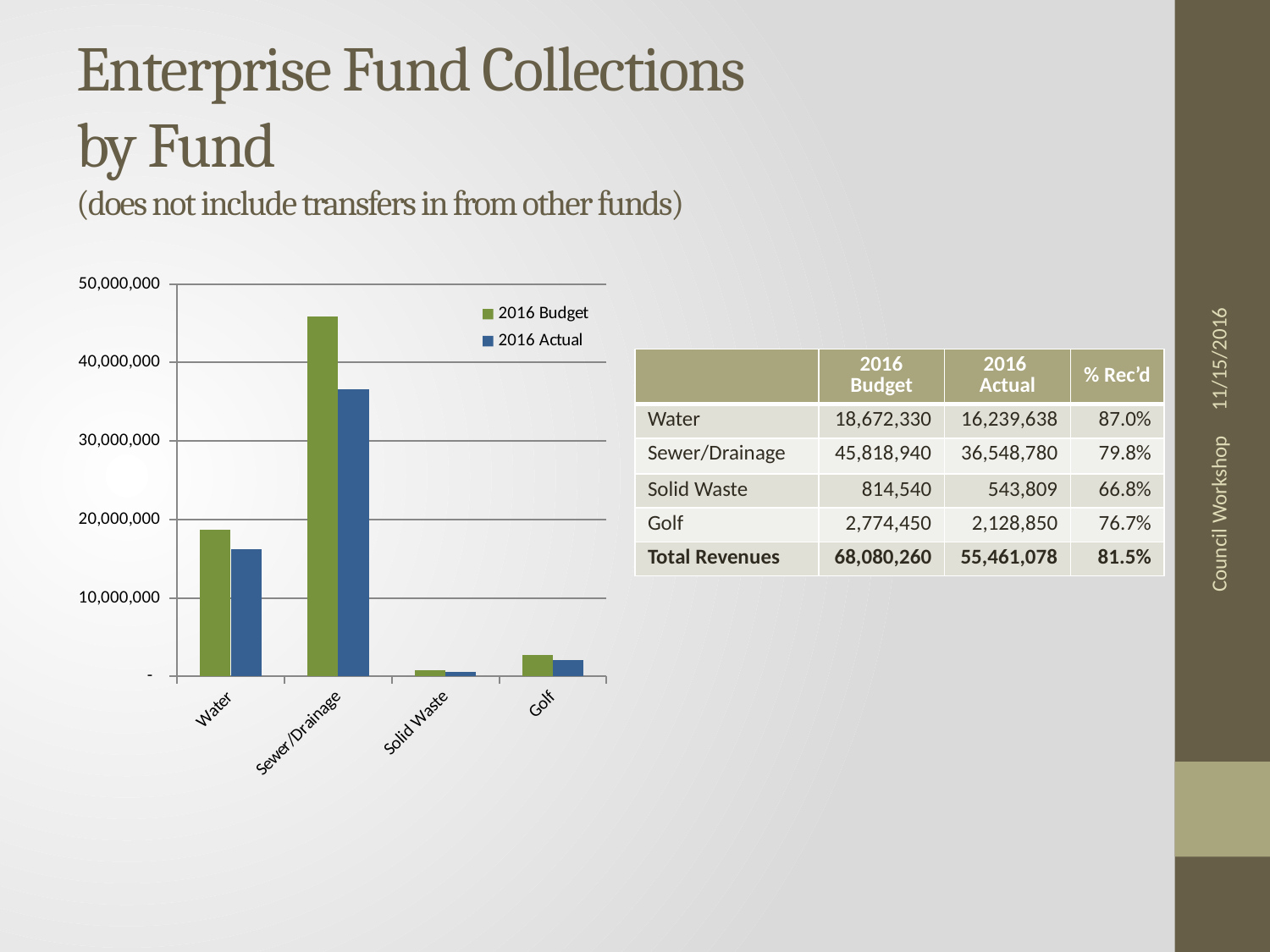
How many fund categories are shown on the x axis of the chart? 4 Is the 2016 Actual bar for Water greater or less than 20,000,000? less Which fund has the highest 2016 Budget bar in the chart? Sewer/Drainage Which fund has the lowest 2016 Actual bar in the chart? Solid Waste What kind of chart is shown on the slide? bar chart According to the table on the slide, what is the 2016 Actual value for Water? 16,239,638 According to the table on the slide, what is the 2016 Budget value for Sewer/Drainage? 45,818,940 Is the 2016 Actual bar for Sewer/Drainage greater or less than 30,000,000? greater How many series does the chart legend list? 2 Is the 2016 Budget bar for Sewer/Drainage greater or less than 40,000,000? greater What colour are the 2016 Budget bars in the chart? green For Golf, which bar is taller: 2016 Budget or 2016 Actual? 2016 Budget